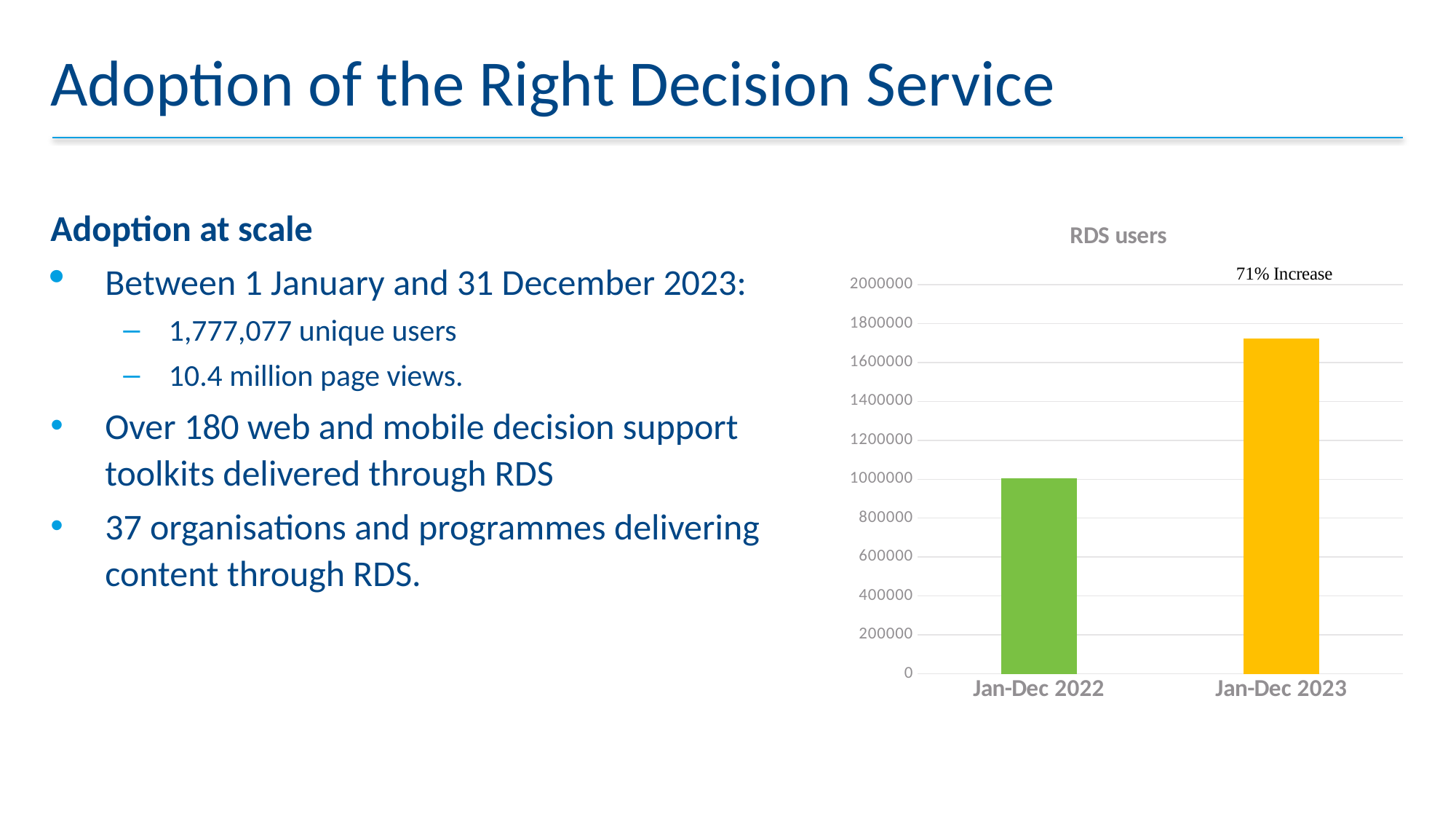
How many categories are plotted in the RDS users chart? 2 Is the value for Jan-Dec 2022 greater or less than 1200000? less Is the value for Jan-Dec 2023 greater or less than 1600000? greater What kind of chart is shown on the slide? bar chart Which category has the lowest value in the RDS users chart? Jan-Dec 2022 Which is larger in the RDS users chart, Jan-Dec 2022 or Jan-Dec 2023? Jan-Dec 2023 Which category has the highest value in the RDS users chart? Jan-Dec 2023 What is the title of the chart on the slide? RDS users Do the values in the RDS users chart rise or fall from Jan-Dec 2022 to Jan-Dec 2023? rise Is the value for Jan-Dec 2023 greater or less than 1800000? less What percentage increase is annotated above the Jan-Dec 2023 bar? 71% Increase